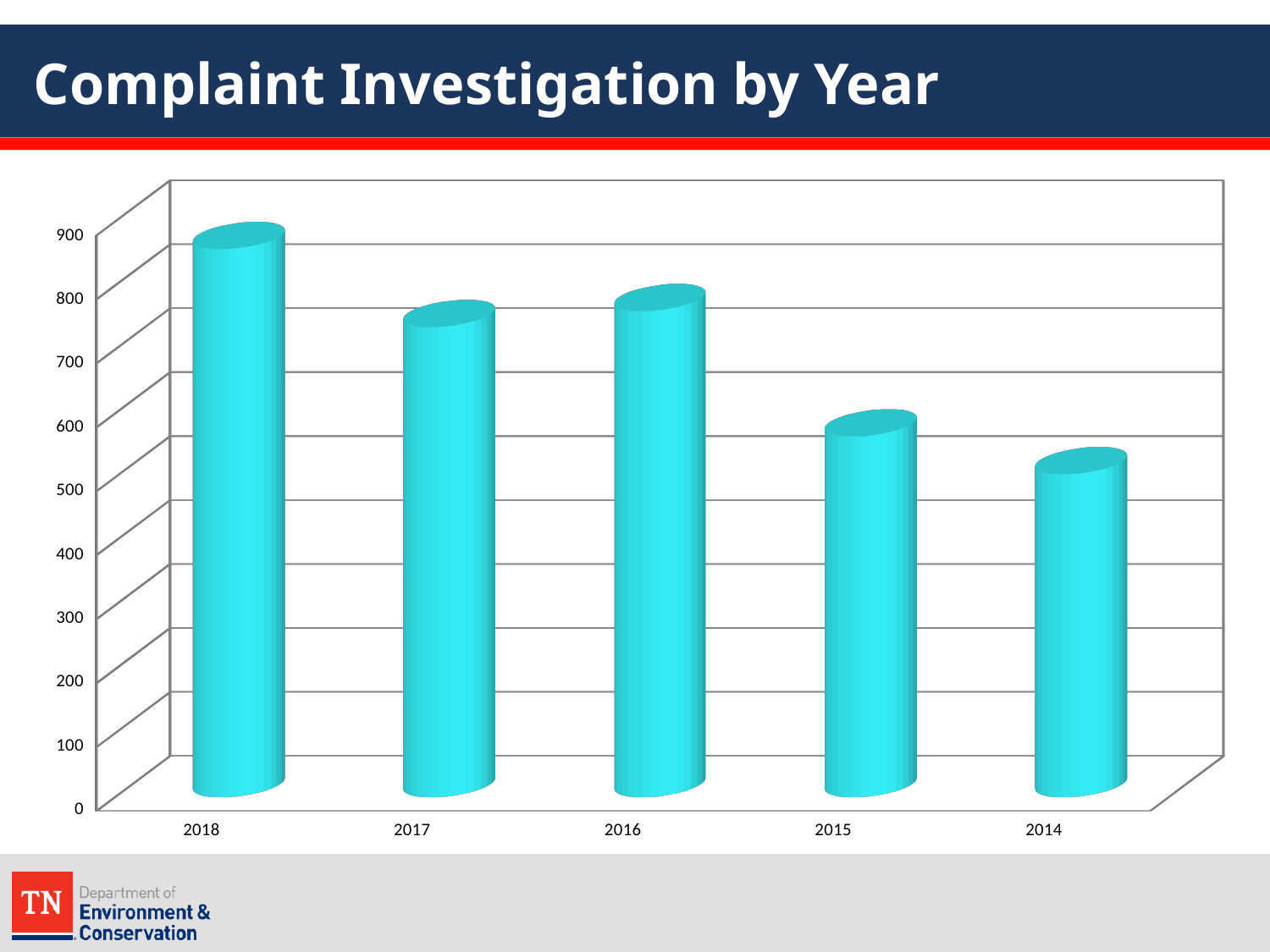
Which is larger, the value for 2018 or the value for 2014? 2018 Is the value for 2016 greater or less than 800? less Is the value for 2015 greater or less than 500? greater Which year has the lowest value in the chart? 2014 Is the value for 2014 greater or less than 600? less How many years are shown on the x axis of the chart? 5 Which is larger, the value for 2015 or the value for 2014? 2015 What is the title of the chart? Complaint Investigation by Year Which year has the highest value in the chart? 2018 What kind of chart is shown on the slide? Bar chart